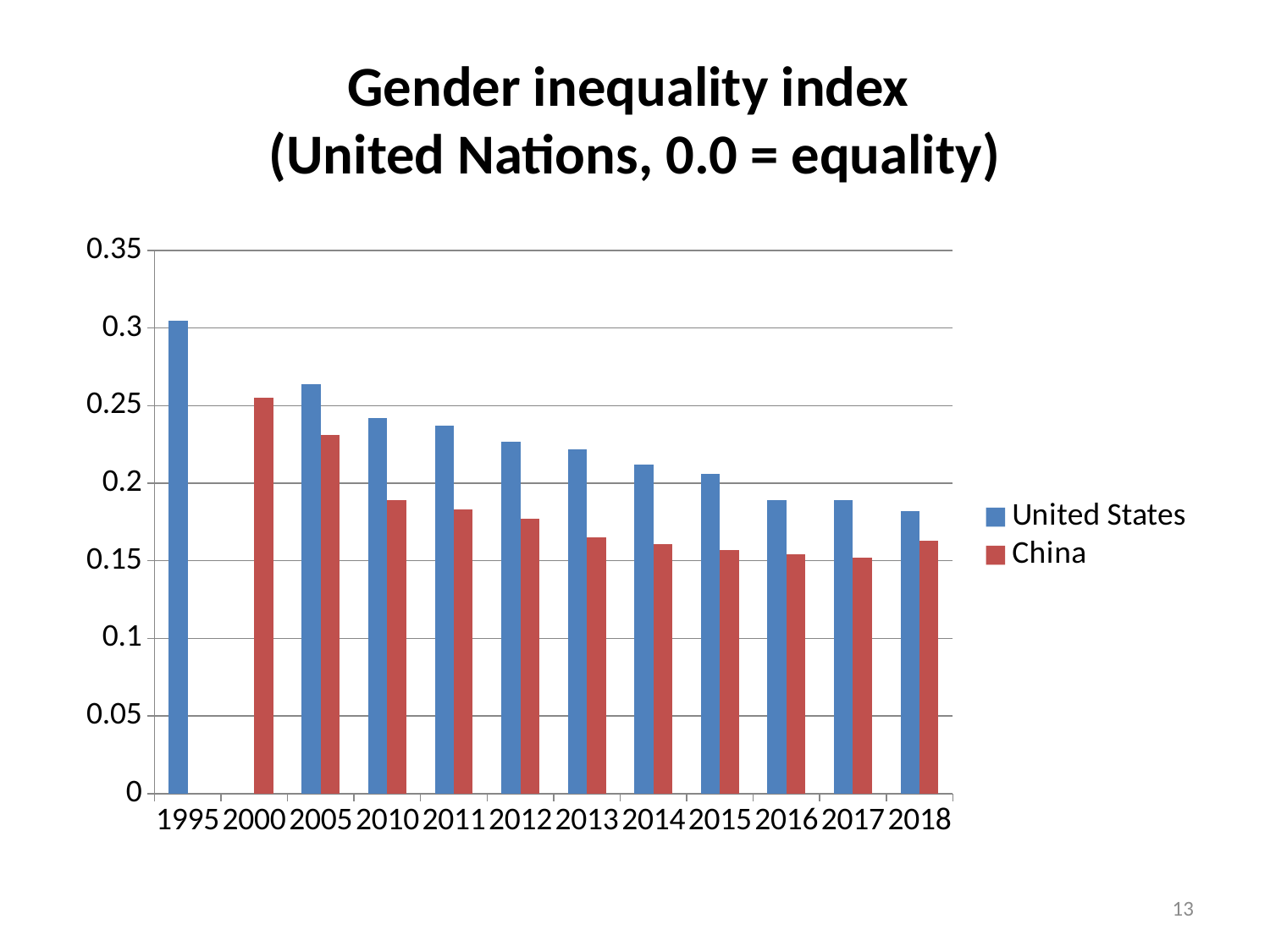
In which year is the China value highest? 2000 In which year is the United States value highest? 1995 Is the China value for 2000 greater or less than 0.2? greater How many series does the legend list? 2 How many years are shown along the x axis? 12 Is the China value for 2013 greater or less than 0.15? greater Do the United States values rise or fall from 1995 to 2018? fall Is the United States value for 2018 greater or less than 0.2? less In 2018, which is larger, the United States value or the China value? United States Which series is shown in red in the legend? China What kind of chart is shown on the slide? Bar chart